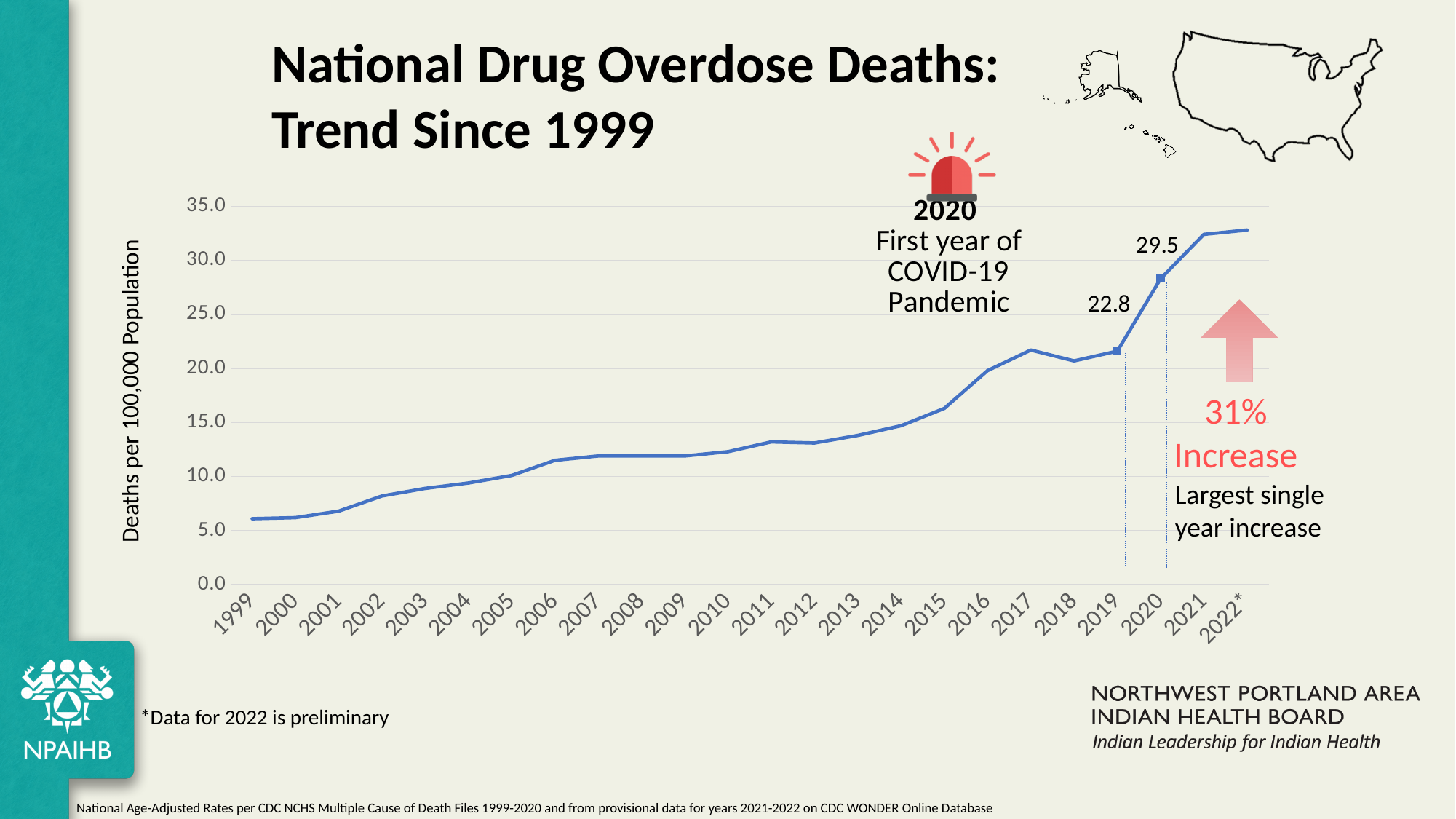
What is the value for 2019? 22.8 Which year has the lowest value? 1999 What is the label of the y axis? Deaths per 100,000 Population How many years are plotted on the x axis? 24 What is the value for 2020? 29.5 Is the value for 2010 greater or less than 15.0? less Is the value for 2022* greater or less than 30.0? greater What kind of chart is shown on the slide? line chart Which is larger, the value for 2021 or the value for 2016? 2021 What is the difference between the values for 2020 and 2019? 6.7 Is the value for 1999 greater or less than 10.0? less Which year has the highest value? 2022*